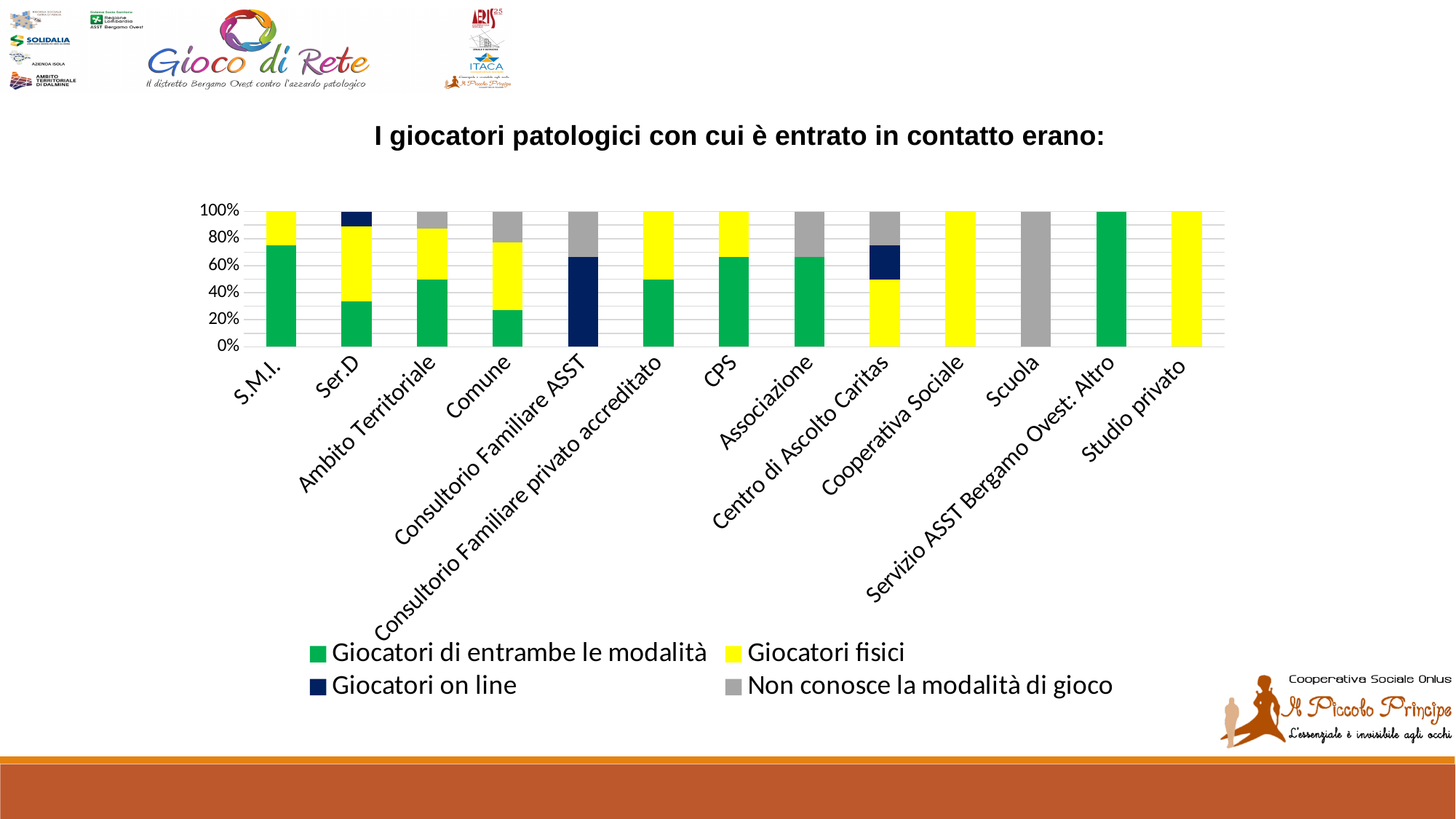
What is the value of 'Giocatori fisici' for Studio privato? 100% What is the value of 'Giocatori fisici' for Cooperativa Sociale? 100% How many series does the chart legend list? 4 What is the value of 'Giocatori di entrambe le modalità' for Servizio ASST Bergamo Ovest: Altro? 100% What is the value of 'Non conosce la modalità di gioco' for Scuola? 100% Which category has the largest share of 'Giocatori on line'? Consultorio Familiare ASST Is the value of 'Giocatori di entrambe le modalità' for S.M.I. greater or less than 60%? greater What kind of chart is shown on the slide? stacked bar chart Which is larger, the 'Giocatori di entrambe le modalità' share for S.M.I. or for Ser.D? S.M.I. Is the value of 'Giocatori di entrambe le modalità' for Comune greater or less than 40%? less Is the value of 'Giocatori on line' for Consultorio Familiare ASST greater or less than 60%? greater How many categories are shown on the x axis of the chart? 13